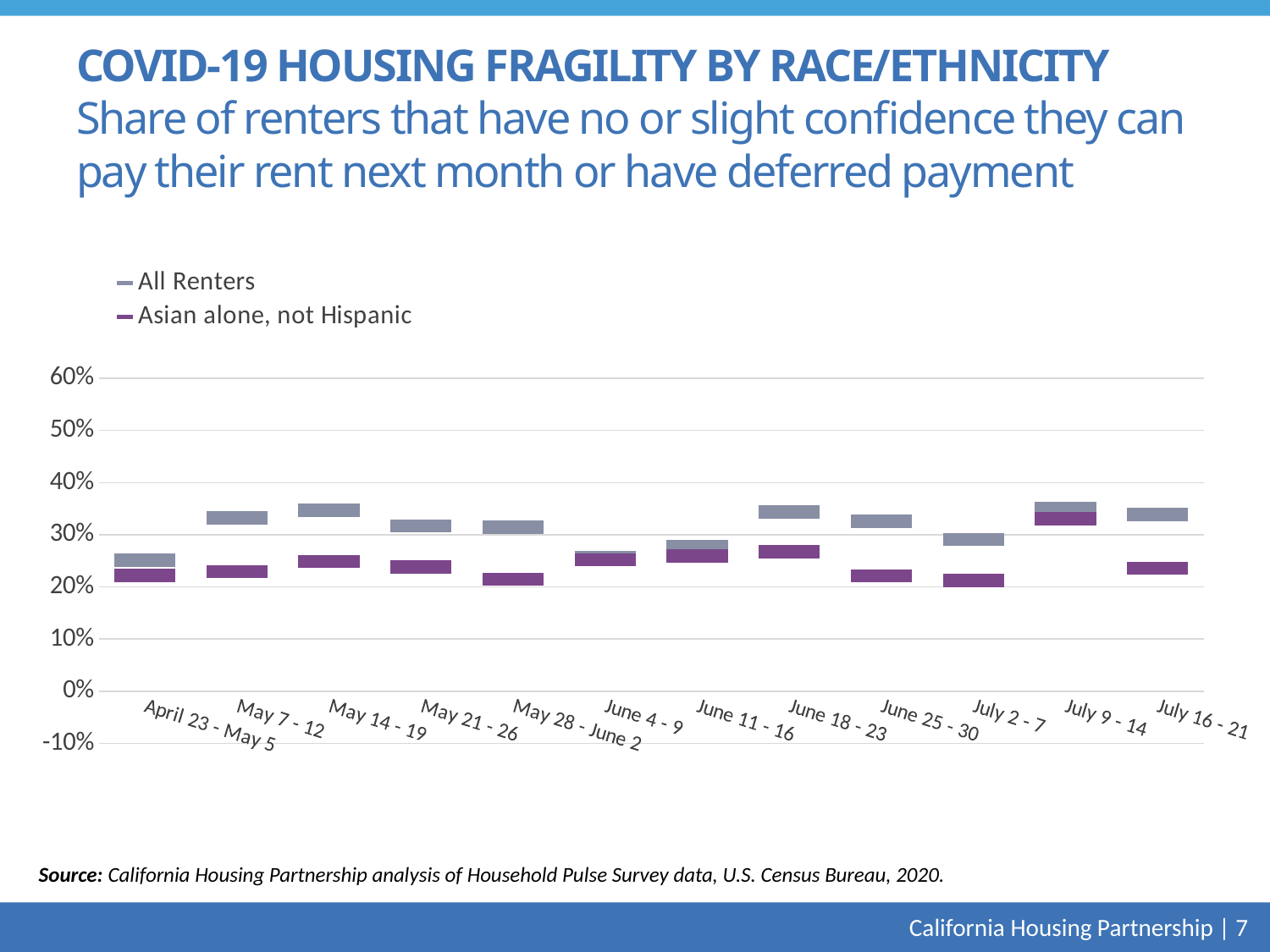
Is the value for All Renters in May 14 - 19 greater or less than 30%? greater Is the value for All Renters in April 23 - May 5 greater or less than 30%? less In May 7 - 12, which series has the larger value, All Renters or Asian alone, not Hispanic? All Renters What colour are the markers for the Asian alone, not Hispanic series? Purple Is the value for Asian alone, not Hispanic in July 9 - 14 greater or less than 30%? greater How many survey periods are shown along the x axis? 12 How many series does the legend list? 2 In which survey period is the value for Asian alone, not Hispanic highest? July 9 - 14 In June 25 - 30, which series has the larger value, All Renters or Asian alone, not Hispanic? All Renters What are the two entries in the chart legend? All Renters; Asian alone, not Hispanic